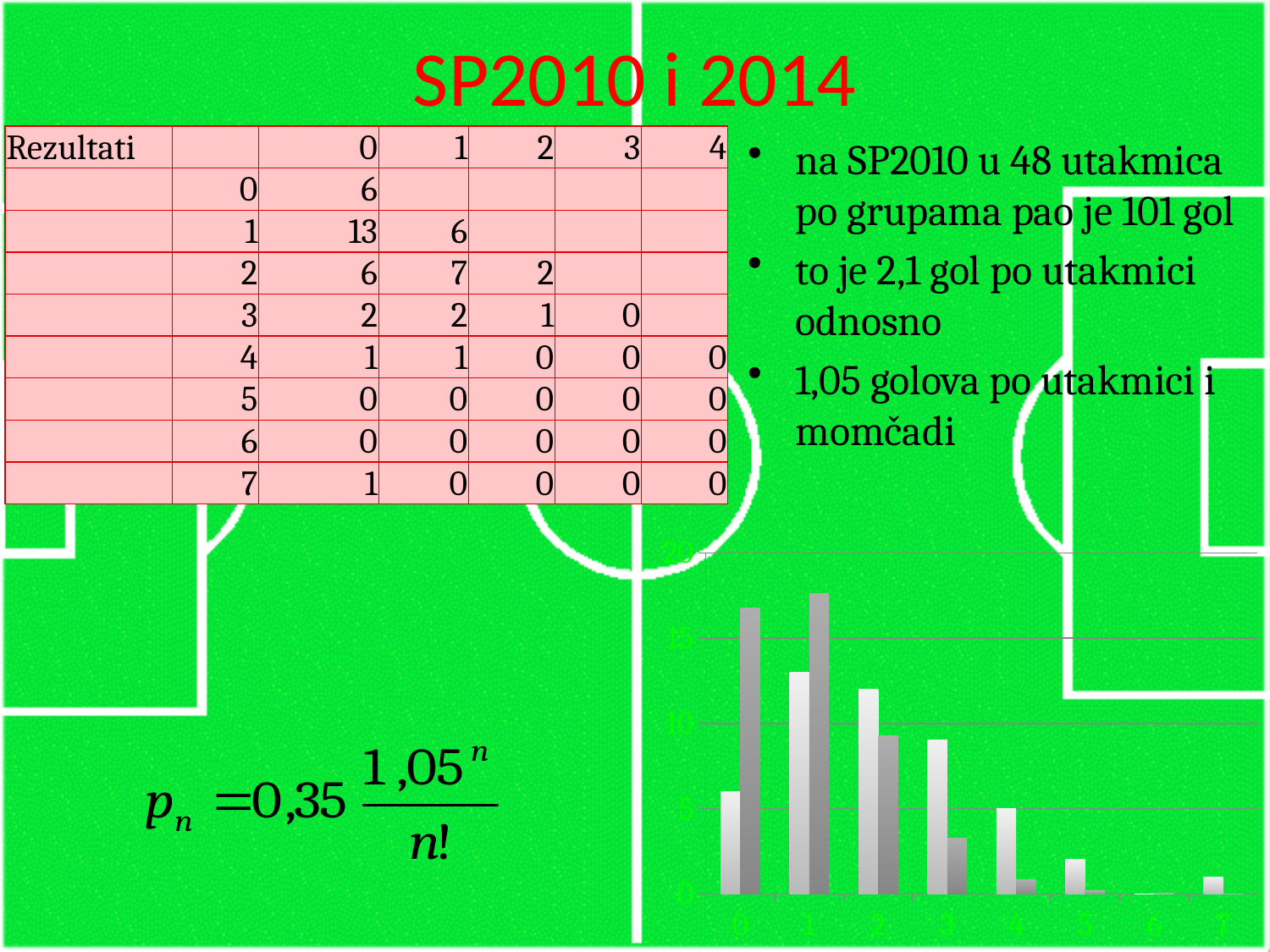
How many categories are shown on the x axis of the bar chart? 8 In the bar chart, is the value of the light bar for category 1 greater or less than 10? greater In the bar chart, is the value of the dark bar for category 0 greater or less than 15? greater In the bar chart, is the value of the dark bar for category 1 greater or less than 15? greater In the bar chart, which is larger for category 0: the light bar or the dark bar? the dark bar What kind of chart is shown at the bottom right of the slide? bar chart In the bar chart, which category has the lowest bars? 6 In the bar chart, do the light bars rise or fall from category 1 to category 6? fall What is the highest value shown on the y axis of the bar chart? 20 In the bar chart, which is larger: the light bar for category 0 or the light bar for category 1? category 1